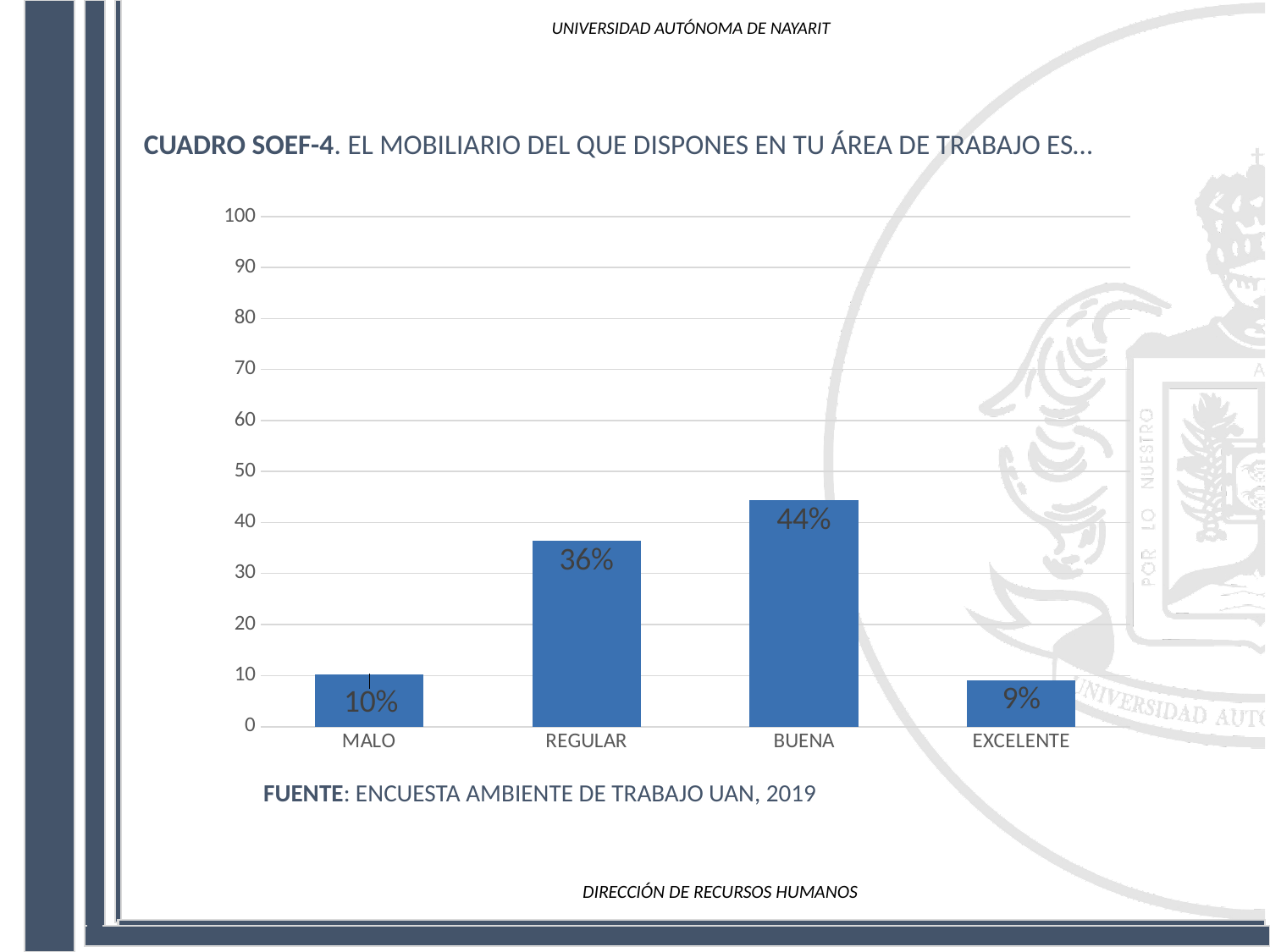
Which is larger, the value for REGULAR or the value for MALO? REGULAR What is the value for EXCELENTE? 9% What is the value for REGULAR? 36% What is the value for MALO? 10% What is the value for BUENA? 44% Is the value for BUENA greater or less than 40? greater What is the difference between the values for BUENA and REGULAR? 8% How many categories are shown on the x axis? 4 Which category has the lowest value? EXCELENTE What is the source cited below the chart? ENCUESTA AMBIENTE DE TRABAJO UAN, 2019 What kind of chart is shown on the slide? Bar chart Which category has the highest value? BUENA